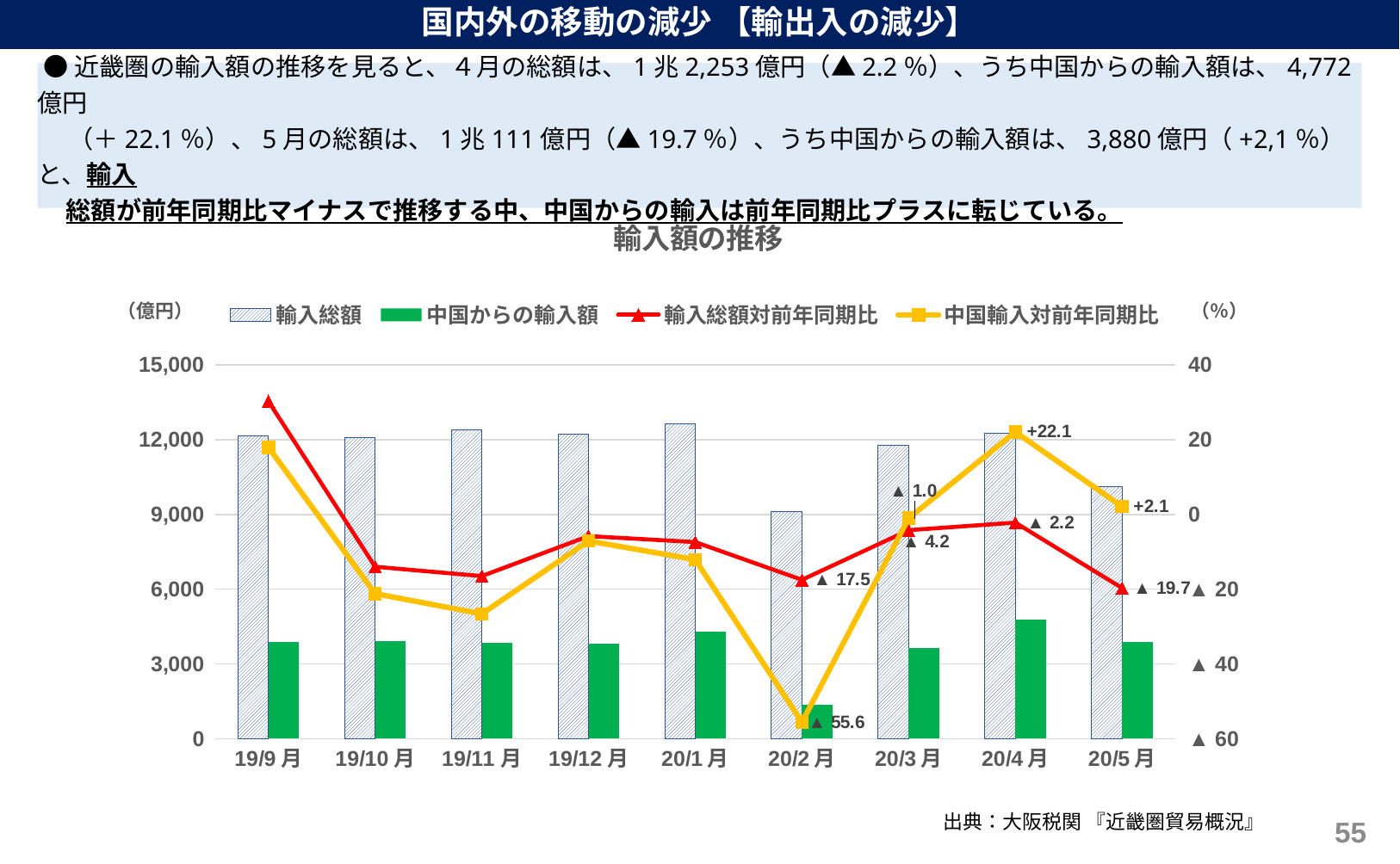
In which month is the 輸入総額 bar the lowest? 20/2月 What is the value of 輸入総額対前年同期比 for 20/5月? ▲19.7 Which is larger, the 中国輸入対前年同期比 value for 20/4月 or for 20/5月? 20/4月 In which month is the 中国からの輸入額 bar the highest? 20/4月 What is the value of 中国輸入対前年同期比 for 20/2月? ▲55.6 Is the 中国からの輸入額 value for 20/2月 greater or less than 3,000? less How many months are shown on the x axis of the chart? 9 What is the value of 中国輸入対前年同期比 for 20/4月? +22.1 What is the title of the chart? 輸入額の推移 What kind of chart is shown on the slide? A combined bar and line chart How many series does the chart's legend list? 4 What is the value of 輸入総額対前年同期比 for 20/2月? ▲17.5